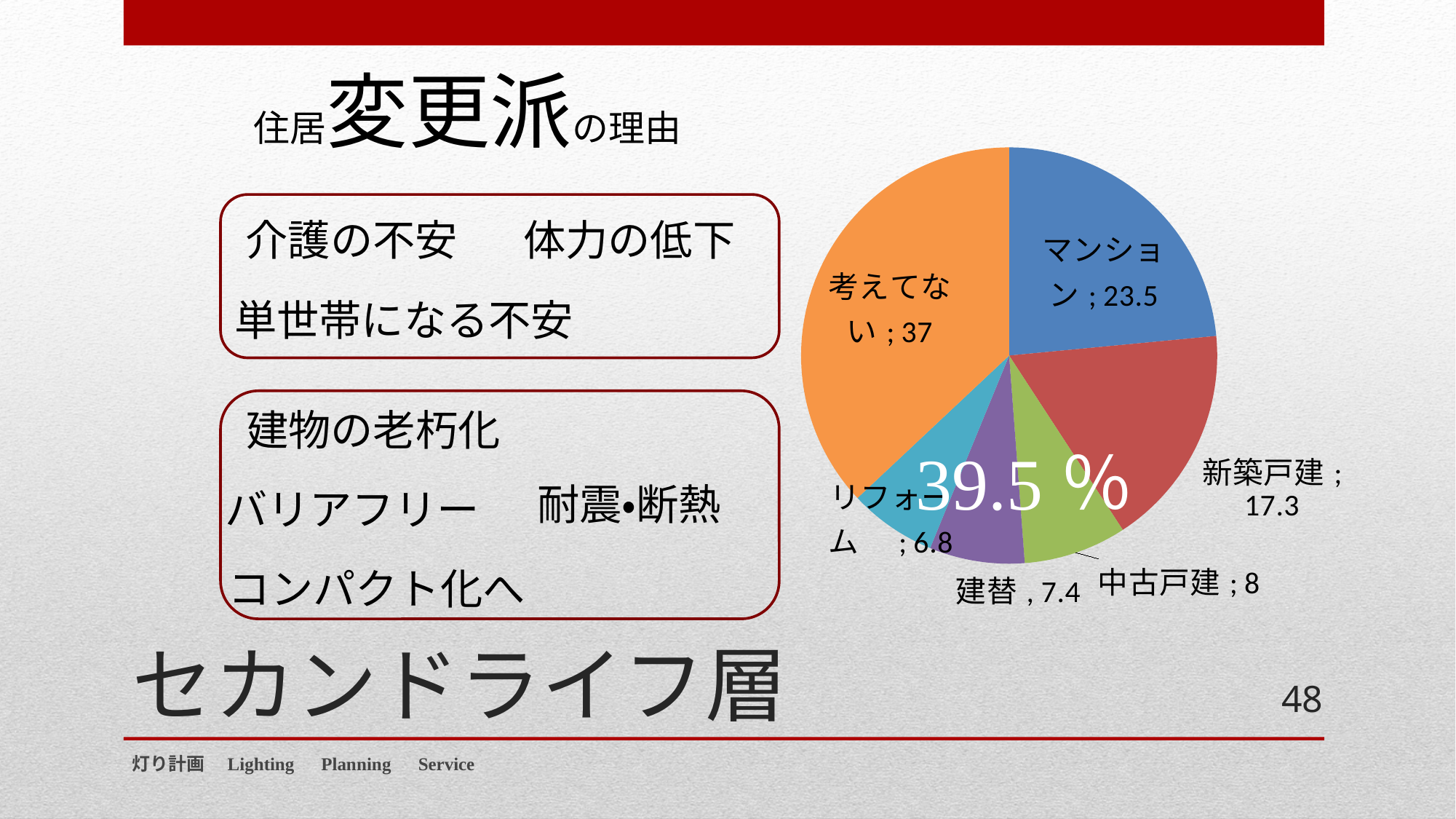
How many slices does the pie chart have? 6 Which slice of the pie chart is the smallest? リフォーム What is the difference between the values for 考えてない and マンション? 13.5 What is the value for リフォーム in the pie chart? 6.8 What percentage is printed in large white text over the pie chart? 39.5 % What is the value for 新築戸建 in the pie chart? 17.3 What is the value for マンション in the pie chart? 23.5 What kind of chart is shown on the slide? pie chart What is the value for 建替 in the pie chart? 7.4 What is the value for 中古戸建 in the pie chart? 8 Which slice of the pie chart is the largest? 考えてない Which is larger, the value for 新築戸建 or the value for 中古戸建? 新築戸建